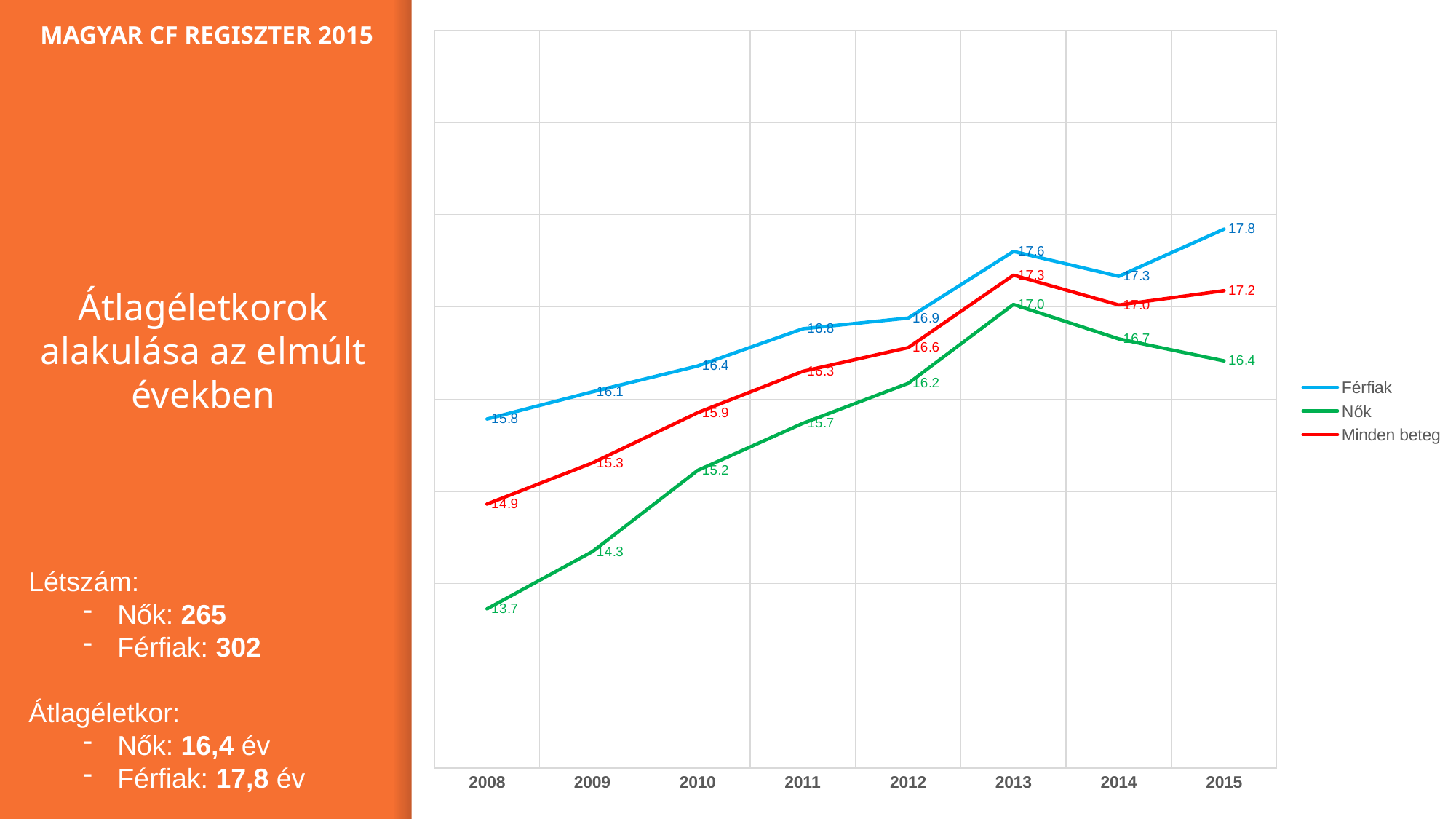
What is the difference between the Férfiak and Nők values in 2015? 1.4 Which is larger in 2014, the value for Férfiak or the value for Nők? Férfiak What is the value for Nők in 2008? 13.7 In which year does the Nők series reach its highest value? 2013 In which year is the Férfiak series at its lowest value? 2008 What is the value for Férfiak in 2015? 17.8 How many series does the chart legend list? 3 How many years are shown on the x axis of the chart? 8 Which series is drawn in red on the chart? Minden beteg Does the Nők series rise or fall between 2013 and 2015? fall What is the value for Minden beteg in 2013? 17.3 What type of chart is shown on the slide? line chart